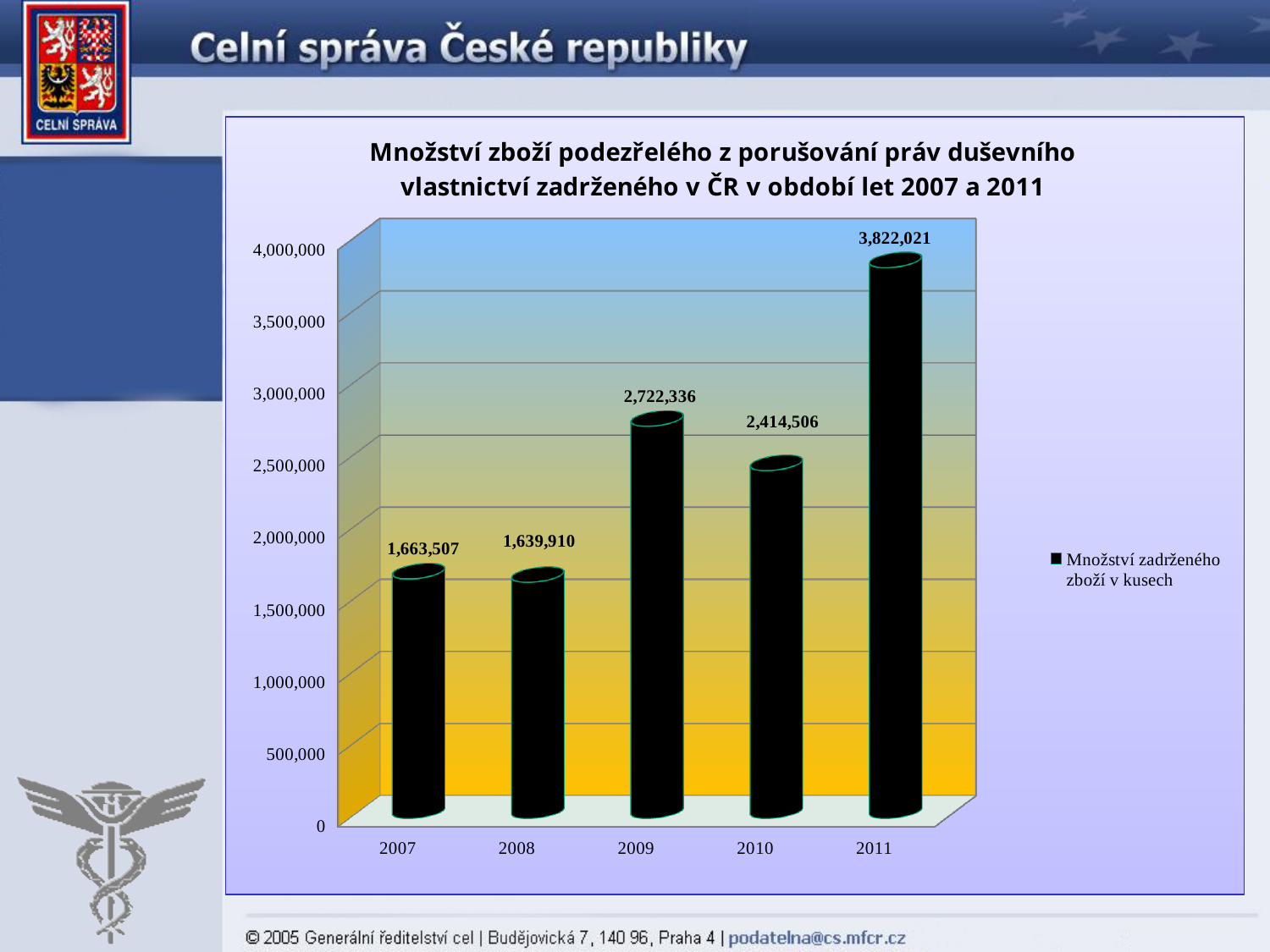
What is the value for 2009? 2,722,336 Which is larger, the value for 2009 or the value for 2010? 2009 What is the value for 2011? 3,822,021 What is the difference between the values for 2009 and 2008? 1,082,426 What kind of chart is this? bar chart Is the value for 2010 greater or less than 2,500,000? less How many years are shown on the x axis? 5 Which year has the highest value? 2011 What is the value for 2008? 1,639,910 Does the value rise or fall from 2009 to 2010? fall Which year has the lowest value? 2008 What is the difference between the values for 2011 and 2010? 1,407,515